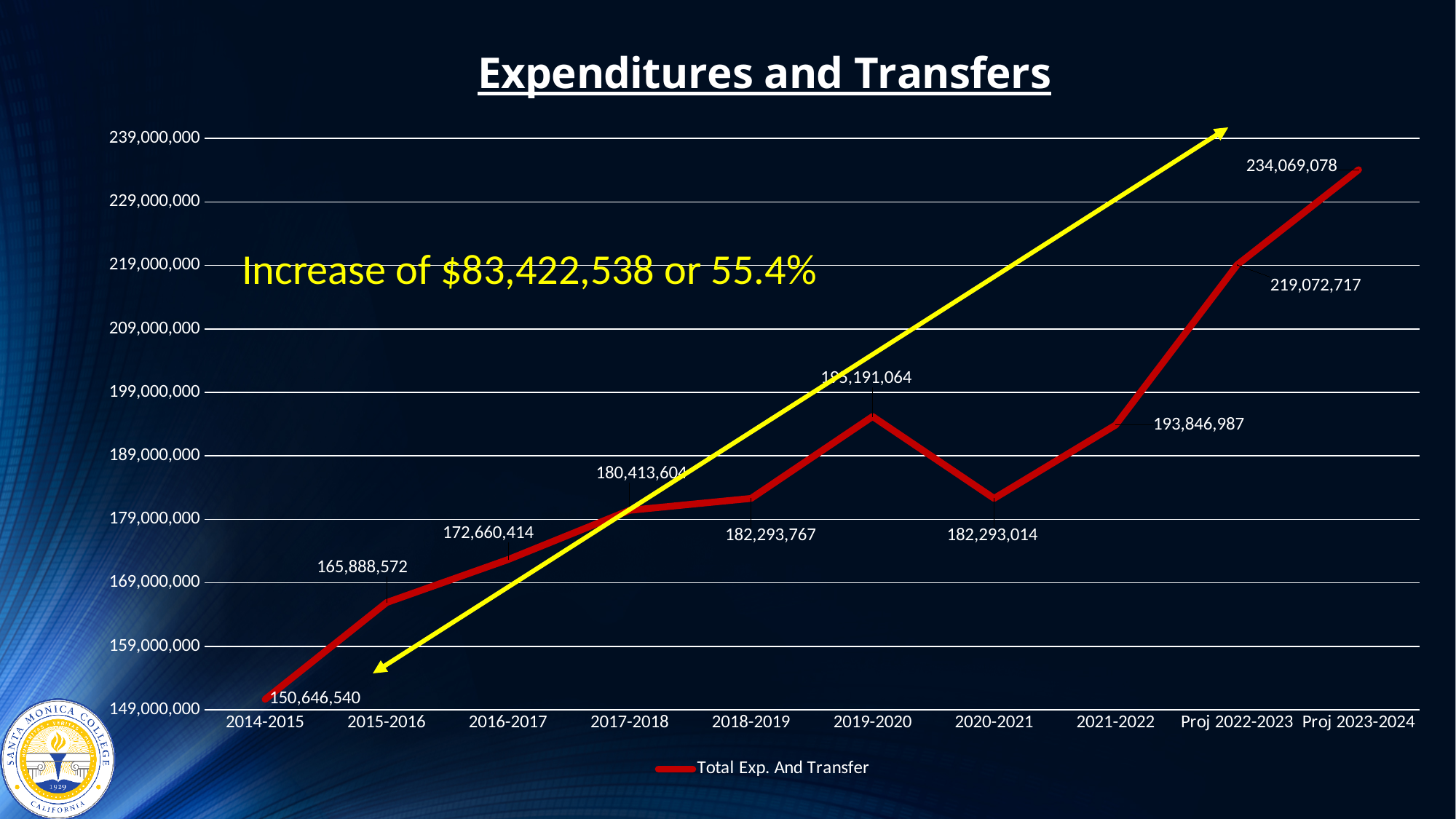
Which year has the lowest value of Total Exp. And Transfer? 2014-2015 What is the value of Total Exp. And Transfer for 2014-2015? 150,646,540 What is the value of Total Exp. And Transfer for 2021-2022? 193,846,987 Is the value for 2019-2020 greater or less than 189,000,000? greater How many series does the legend list? 1 Which year has the highest value of Total Exp. And Transfer? Proj 2023-2024 What is the value of Total Exp. And Transfer for 2017-2018? 180,413,604 What is the difference between the 2015-2016 value and the 2014-2015 value? 15,242,032 What type of chart is shown on the slide? line chart What is the value of Total Exp. And Transfer for Proj 2022-2023? 219,072,717 What is the difference between the Proj 2023-2024 value and the 2014-2015 value? 83,422,538 How many years are plotted on the x axis? 10